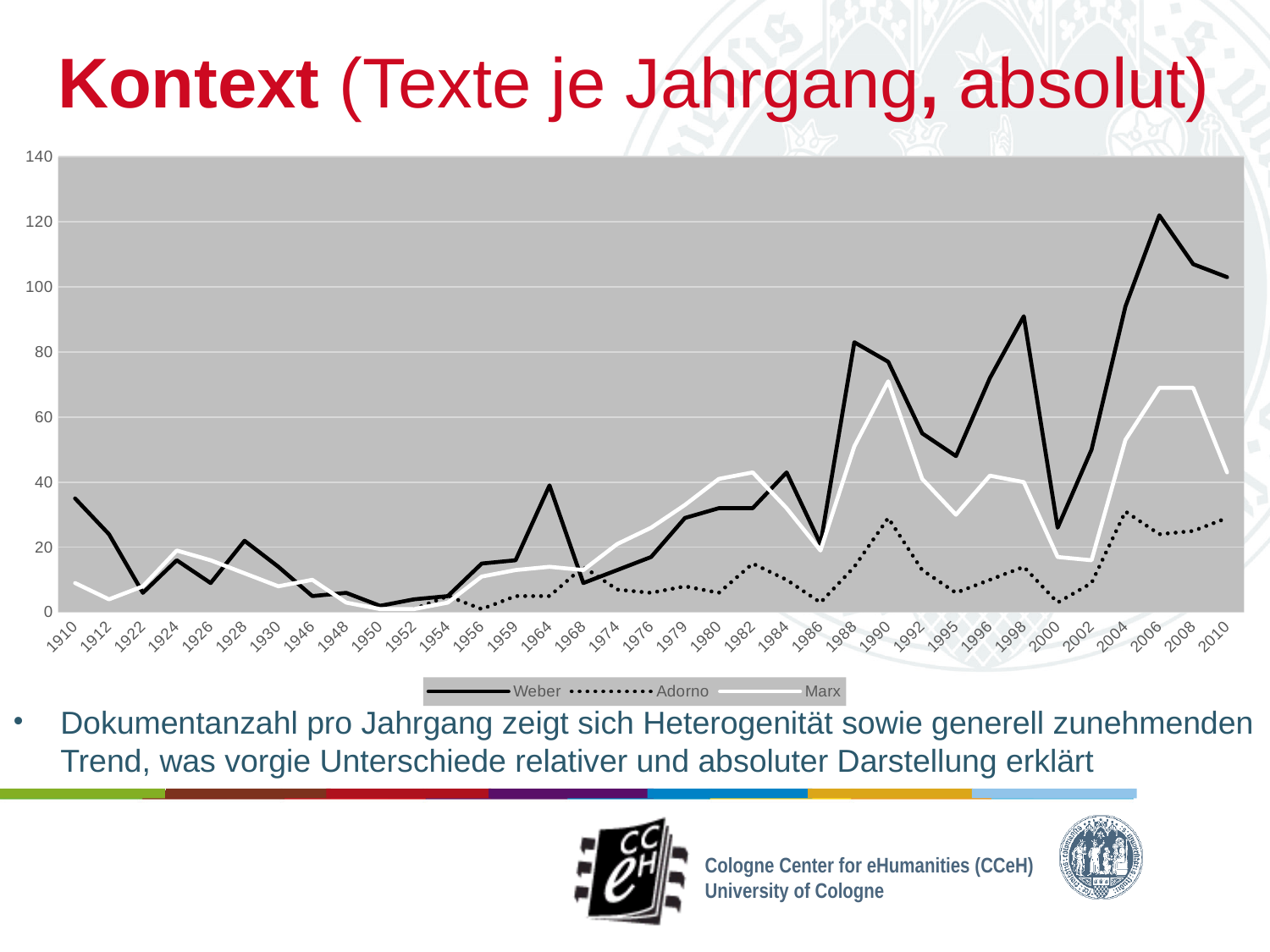
Is the value for Adorno in 1990 greater or less than 40? less How many series does the legend list? 3 Which series has the highest value in 2010? Weber In 1982, which is larger: the value for Marx or the value for Weber? Marx Is the value for Marx in 2006 greater or less than 60? greater How many years are labelled along the x axis? 35 Which series is drawn with a dotted line? Adorno What kind of chart is shown on the slide? line chart In which year does the Weber series reach its highest value? 2006 Is the value for Weber in 1950 greater or less than 20? less Does the Weber series overall rise or fall from 1910 to 2010? rise